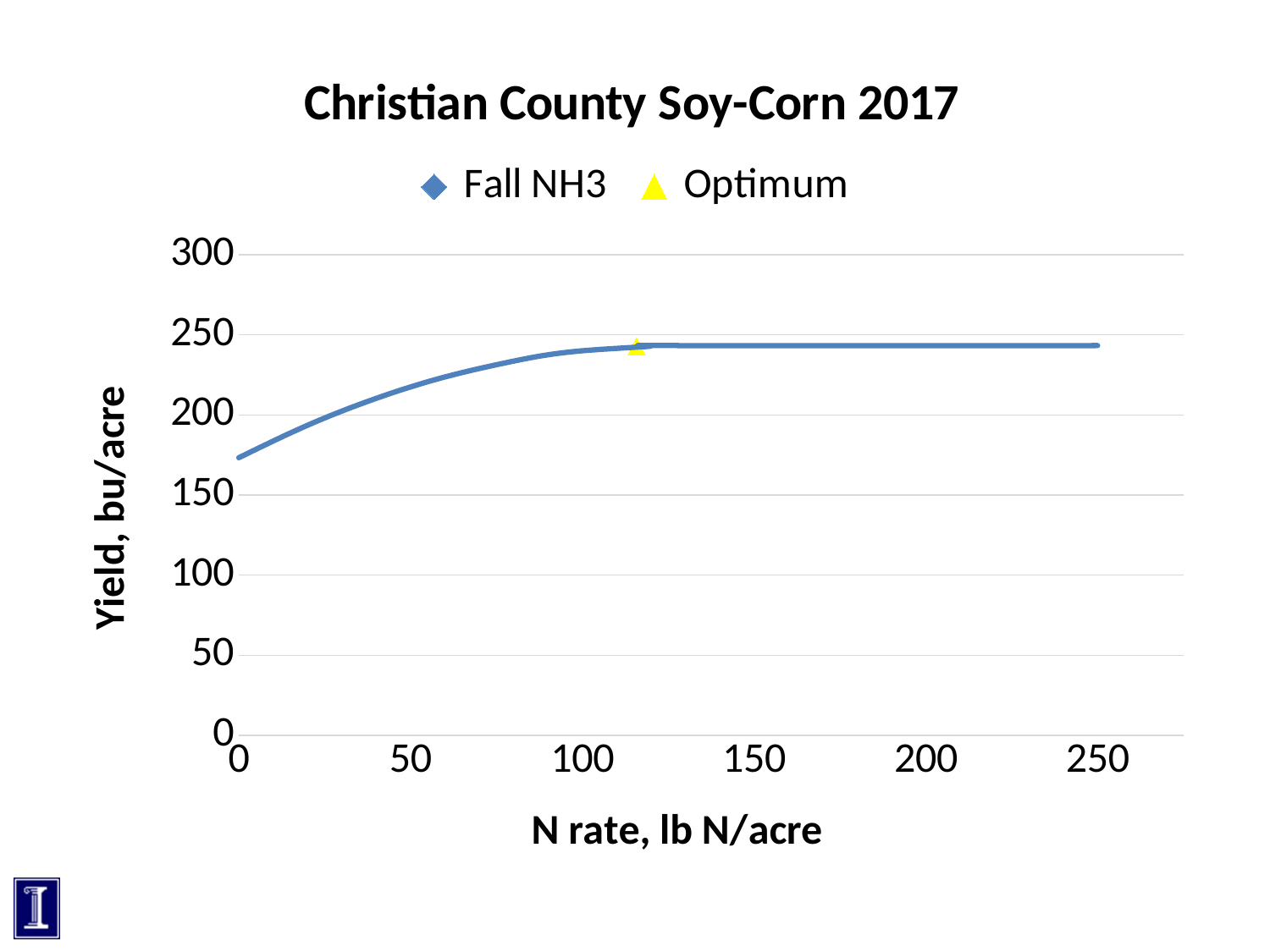
Which is larger, the Fall NH3 yield at an N rate of 0 or at an N rate of 250? at an N rate of 250 Is the N rate at the Optimum point greater or less than 150 lb N/acre? less Is the Fall NH3 yield at an N rate of 250 greater or less than 200 bu/acre? greater Does the Fall NH3 yield rise or fall as the N rate increases from 0 to 100 lb N/acre? rise What are the two series named in the legend? Fall NH3 and Optimum Is the Fall NH3 yield at an N rate of 0 greater or less than 200 bu/acre? less How many series does the legend list? 2 What kind of chart is shown? line chart What is the title of the chart? Christian County Soy-Corn 2017